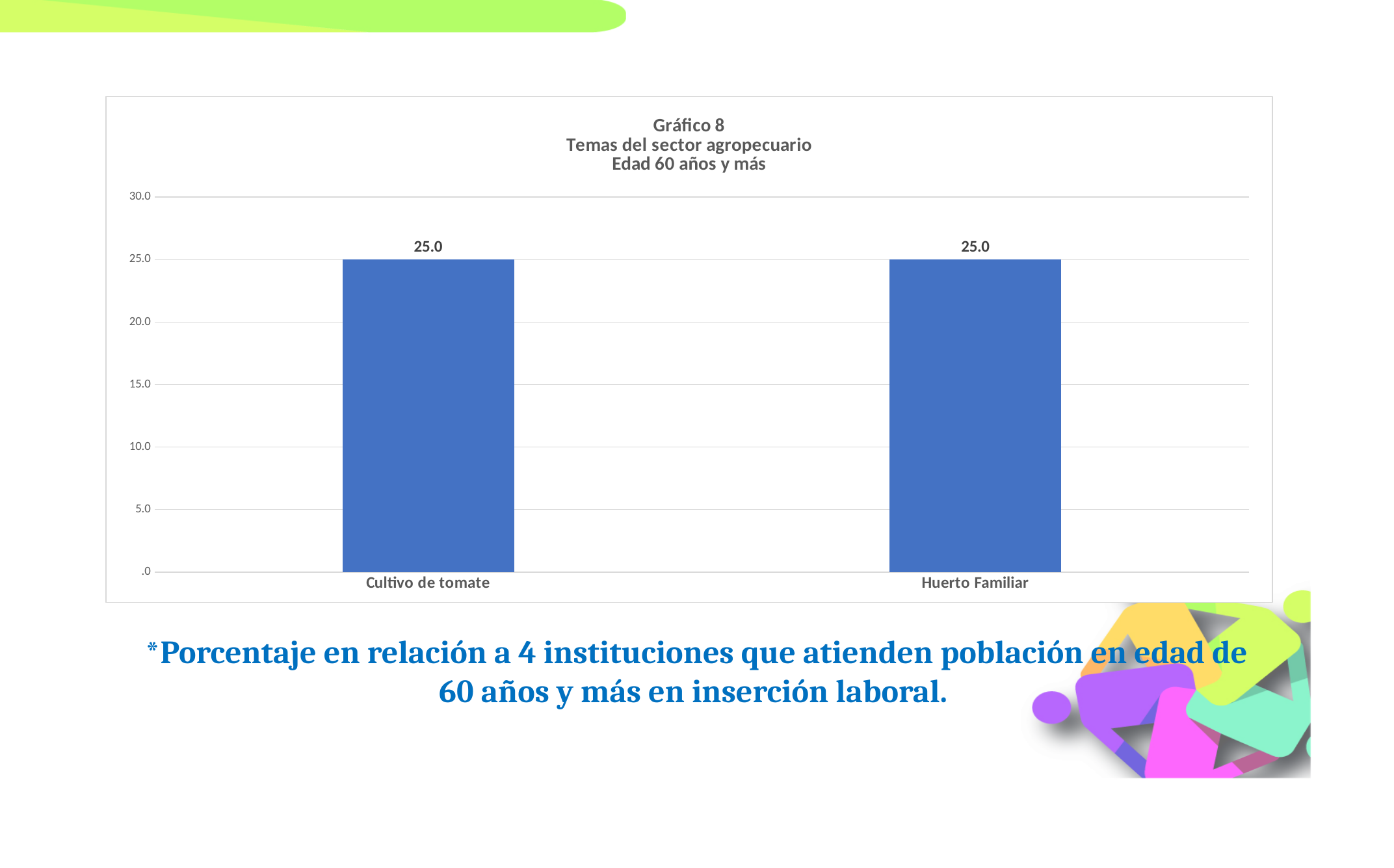
How many categories are shown on the x axis? 2 What kind of chart is shown on the slide? bar chart Do the values rise, fall or stay the same from Cultivo de tomate to Huerto Familiar? stay the same What is the value for Cultivo de tomate? 25.0 What is the highest value shown on the y axis? 30.0 What is the title of the chart? Gráfico 8 Temas del sector agropecuario Edad 60 años y más Is the value for Huerto Familiar greater or less than 30.0? less Is the value for Cultivo de tomate greater or less than 20.0? greater What colour are the bars in the chart? blue What is the difference between the values for Cultivo de tomate and Huerto Familiar? 0.0 What is the value for Huerto Familiar? 25.0